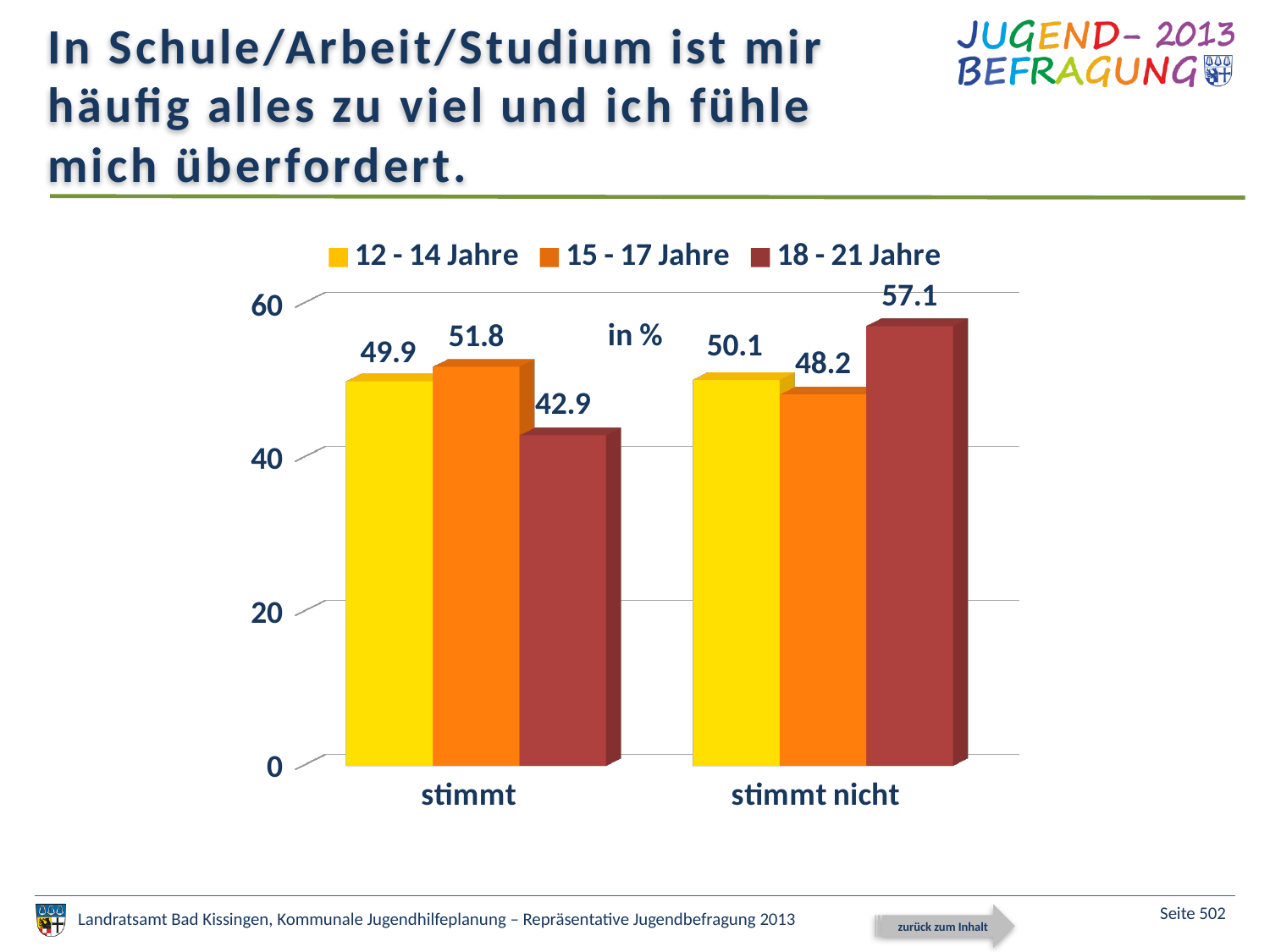
What is the value for the 18 - 21 Jahre series in the "stimmt" category? 42.9 How many series does the legend list? 3 Is the value for 18 - 21 Jahre in the "stimmt" category greater or less than 40? greater What is the value for the 12 - 14 Jahre series in the "stimmt" category? 49.9 Which is larger: the 15 - 17 Jahre value for "stimmt" or for "stimmt nicht"? stimmt What kind of chart is shown on the slide? bar chart What is the value for the 15 - 17 Jahre series in the "stimmt" category? 51.8 Which age group has the highest value in the "stimmt nicht" category? 18 - 21 Jahre Which age group has the lowest value in the "stimmt" category? 18 - 21 Jahre What is the value for the 18 - 21 Jahre series in the "stimmt nicht" category? 57.1 What is the difference between the 18 - 21 Jahre values for "stimmt nicht" and "stimmt"? 14.2 How many categories are shown on the x axis? 2